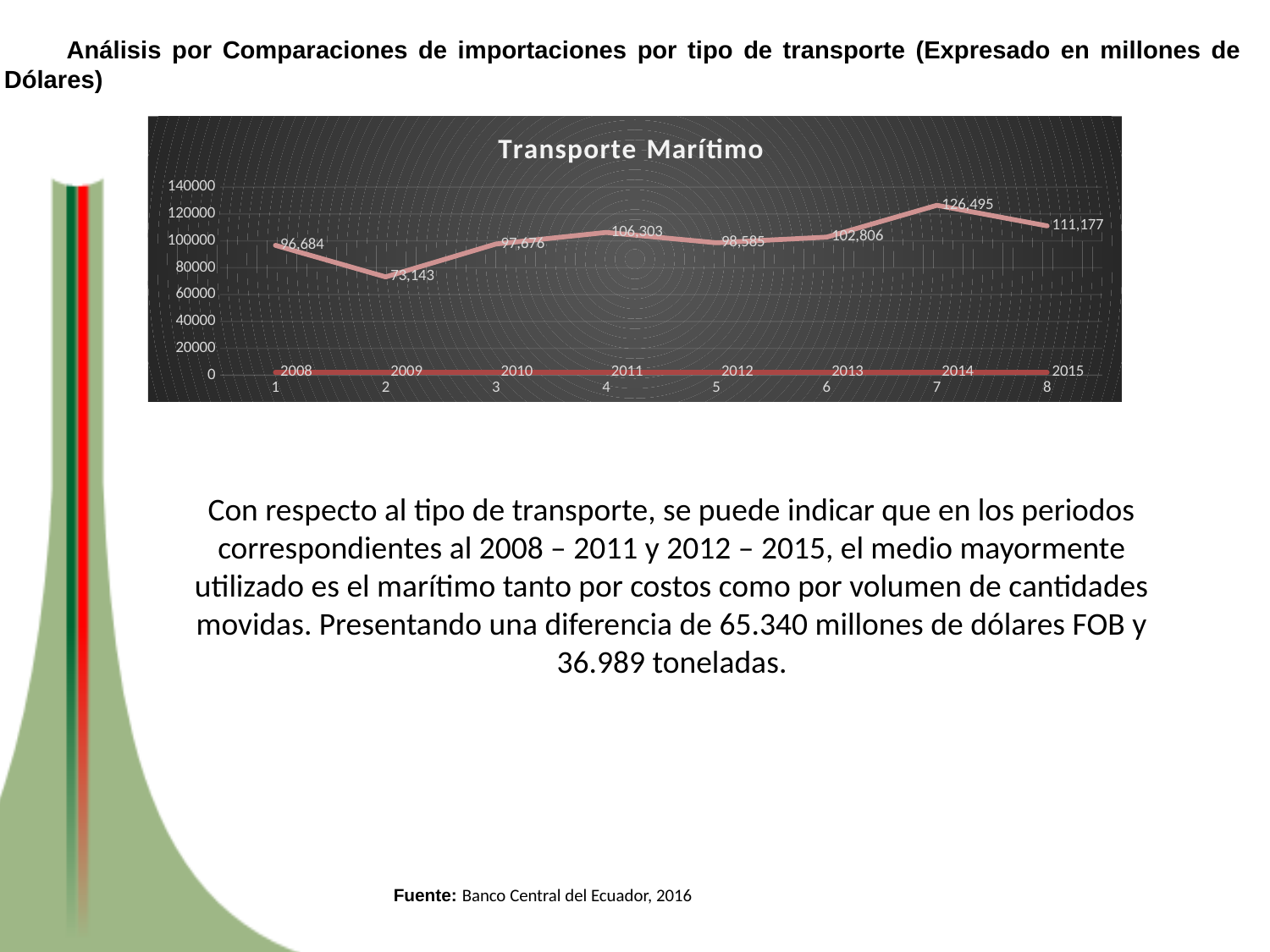
What kind of chart is the Transporte Marítimo chart? line chart What is the value for 2014 in the Transporte Marítimo chart? 126,495 Which year has the lowest value in the Transporte Marítimo chart? 2009 How many years are plotted in the Transporte Marítimo chart? 8 What is the difference between the values for 2014 and 2015 in the Transporte Marítimo chart? 15,318 Which is larger in the Transporte Marítimo chart, the value for 2011 or the value for 2012? 2011 What is the value for 2009 in the Transporte Marítimo chart? 73,143 What is the difference between the values for 2008 and 2009 in the Transporte Marítimo chart? 23,541 Which year has the highest value in the Transporte Marítimo chart? 2014 What is the value for 2011 in the Transporte Marítimo chart? 106,303 What is the value for 2015 in the Transporte Marítimo chart? 111,177 Is the value for 2014 in the Transporte Marítimo chart greater or less than 120000? greater